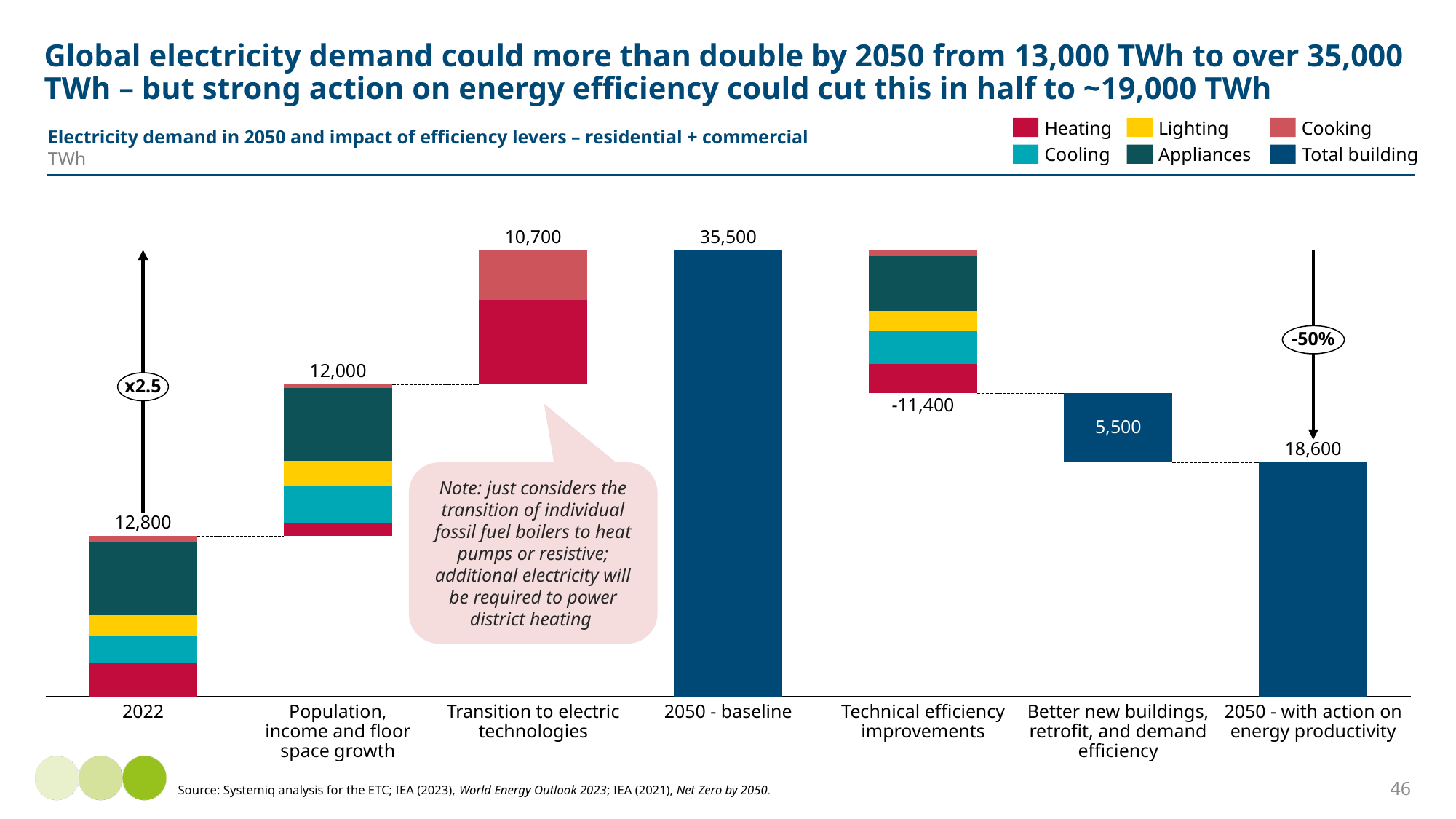
Which category has the highest bar? 2050 - baseline How many series does the legend list? 6 What is the value labelled on the Transition to electric technologies bar? 10,700 What is the value labelled on the Better new buildings, retrofit, and demand efficiency bar? 5,500 Which is larger, the value for 2022 or the value for Population, income and floor space growth? 2022 What is the value shown for 2050 - with action on energy productivity? 18,600 What multiplier is shown in the oval label next to the arrow on the left of the chart? x2.5 What is the value shown for 2022? 12,800 How many categories are shown along the x axis? 7 What value is labelled on the Technical efficiency improvements bar? -11,400 What is the difference between the 2050 - baseline value and the 2050 - with action on energy productivity value? 16,900 What is the value shown for the 2050 - baseline bar? 35,500